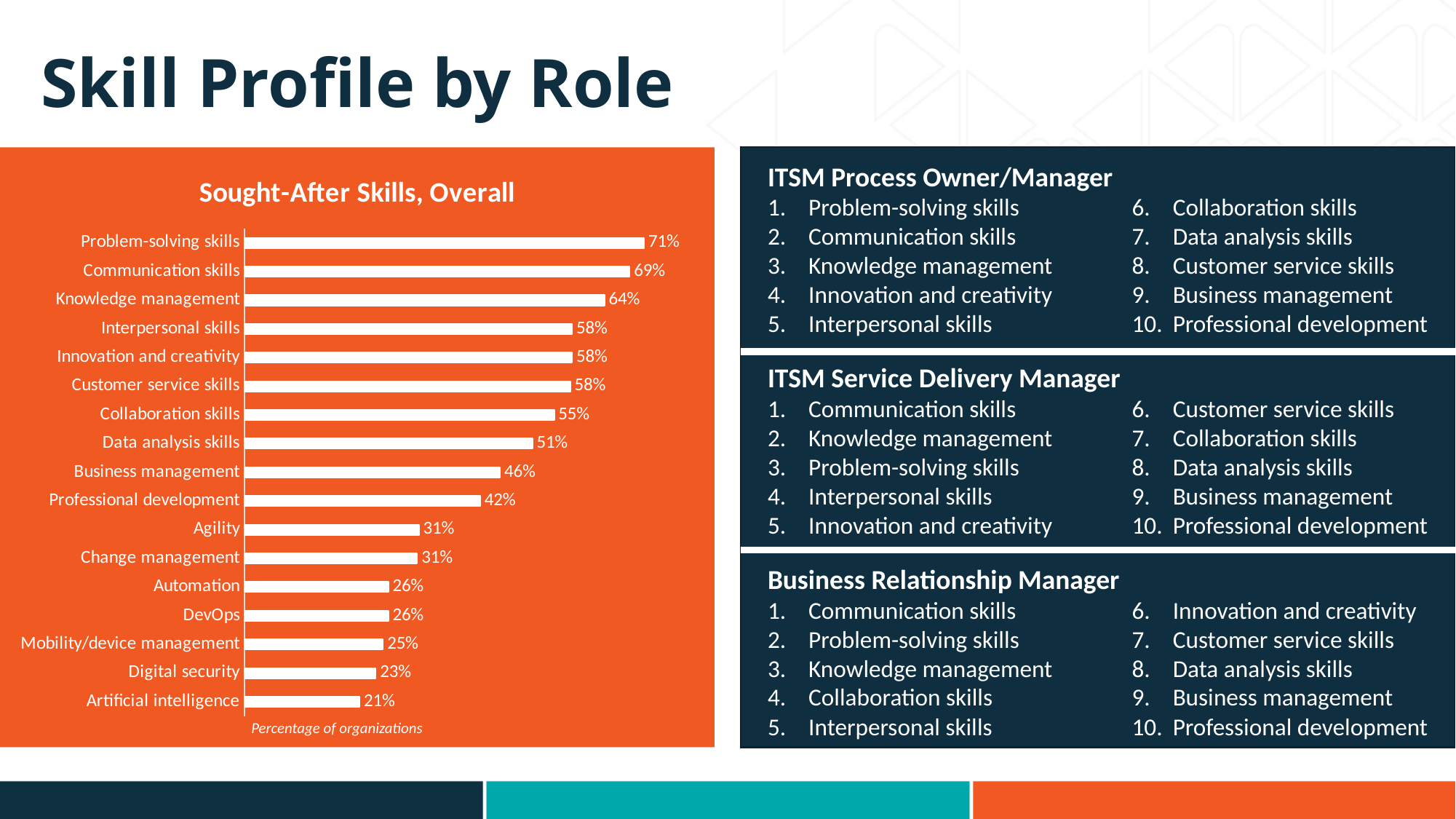
What is the difference between Business management and Professional development in the Sought-After Skills, Overall chart? 4% What is the difference between Communication skills and Knowledge management in the Sought-After Skills, Overall chart? 5% What percentage of organizations sought Problem-solving skills in the Sought-After Skills, Overall chart? 71% What does the axis note below the bars in the Sought-After Skills, Overall chart say the values represent? Percentage of organizations What is the value for Data analysis skills in the Sought-After Skills, Overall chart? 51% What kind of chart is the Sought-After Skills, Overall chart? Bar chart Which skill has the highest value in the Sought-After Skills, Overall chart? Problem-solving skills How many skills are plotted in the Sought-After Skills, Overall chart? 17 Which skill has the lowest value in the Sought-After Skills, Overall chart? Artificial intelligence What is the value for Digital security in the Sought-After Skills, Overall chart? 23% What is the title of the chart on the slide? Sought-After Skills, Overall Which is larger in the Sought-After Skills, Overall chart: Collaboration skills or Business management? Collaboration skills